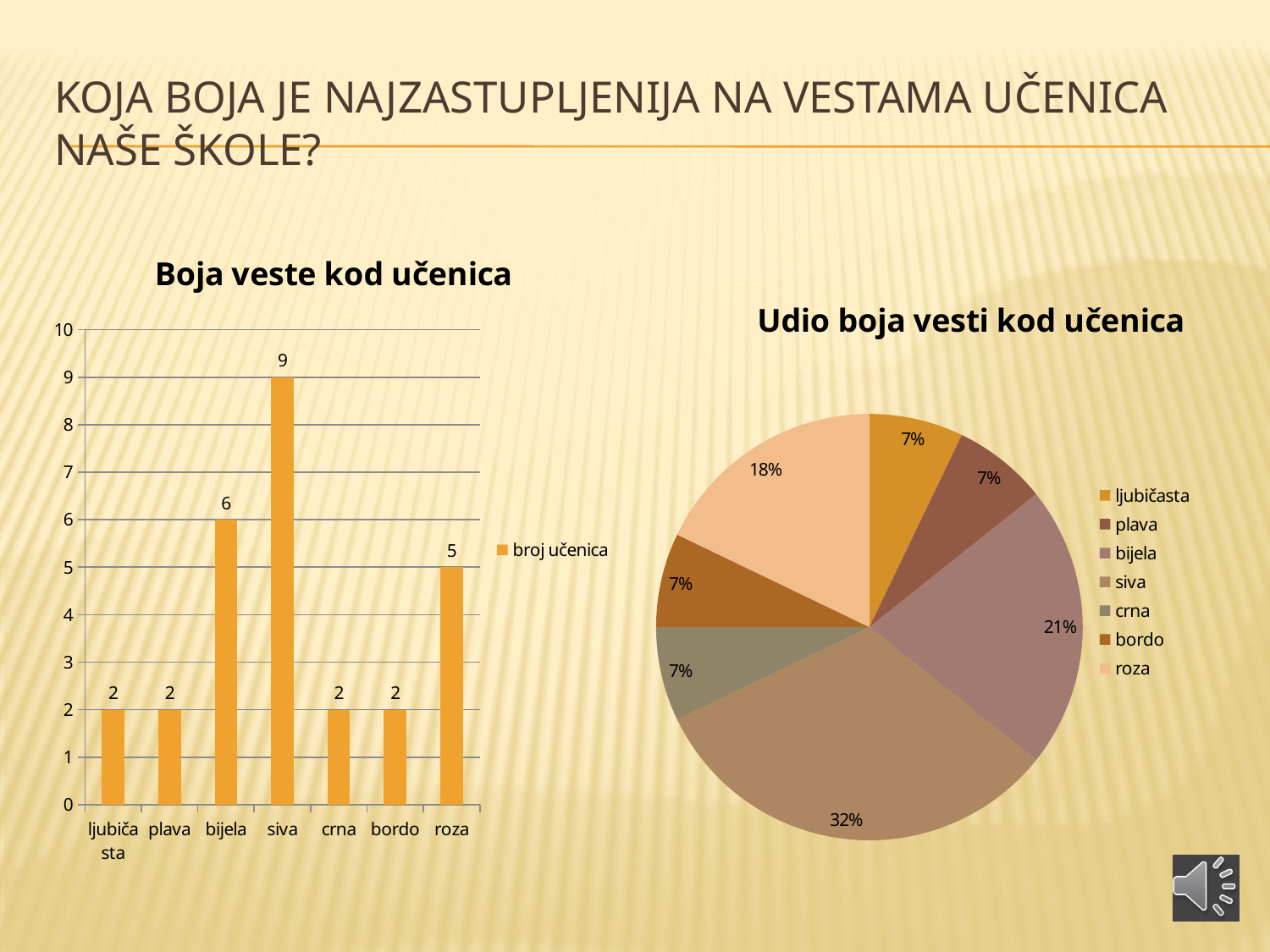
In the bar chart 'Boja veste kod učenica', what is the value for roza? 5 In the bar chart 'Boja veste kod učenica', what series name does the legend show? broj učenica In the pie chart 'Udio boja vesti kod učenica', how many entries does the legend list? 7 In the bar chart 'Boja veste kod učenica', what is the difference between the values for siva and bijela? 3 In the bar chart 'Boja veste kod učenica', which is larger, the value for bijela or the value for roza? bijela In the bar chart 'Boja veste kod učenica', which category has the highest value? siva In the pie chart 'Udio boja vesti kod učenica', what share does roza have? 18% In the bar chart 'Boja veste kod učenica', how many categories are shown on the x axis? 7 What kind of chart is 'Boja veste kod učenica'? bar chart In the pie chart 'Udio boja vesti kod učenica', what share does siva have? 32% What kind of chart is 'Udio boja vesti kod učenica'? pie chart In the bar chart 'Boja veste kod učenica', what is the value for siva? 9